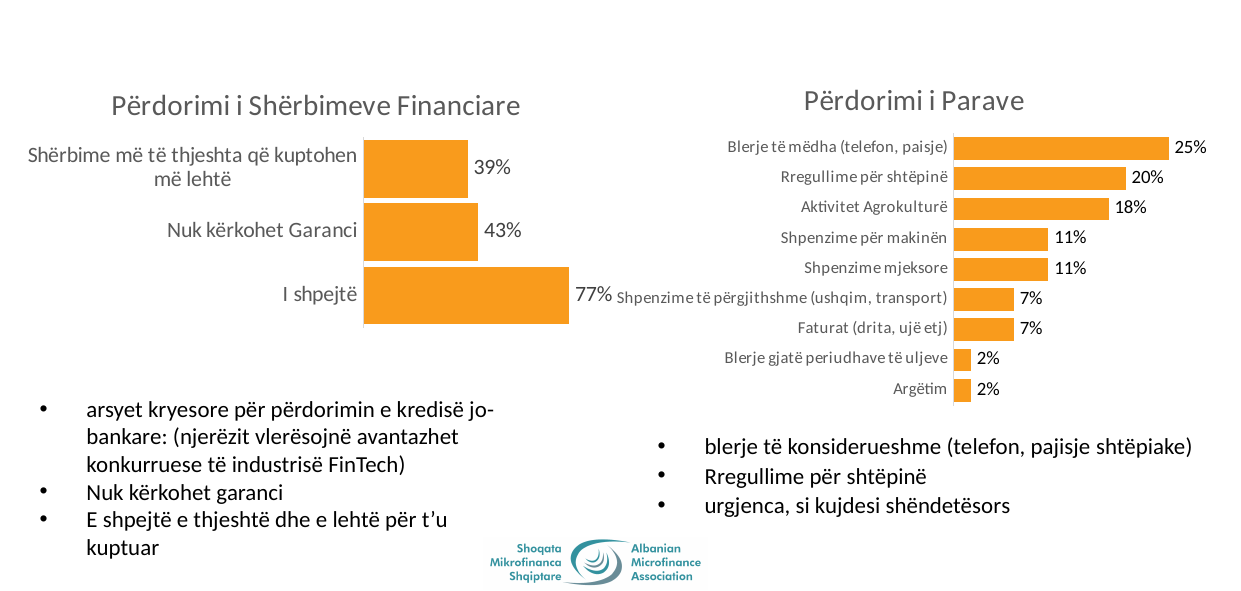
In the chart titled "Përdorimi i Parave", what is the value for "Aktivitet Agrokulturë"? 18% In the chart titled "Përdorimi i Parave", which is larger: "Shpenzime mjeksore" or "Faturat (drita, ujë etj)"? Shpenzime mjeksore In the chart titled "Përdorimi i Shërbimeve Financiare", what is the value for "Nuk kërkohet Garanci"? 43% In the chart titled "Përdorimi i Shërbimeve Financiare", which category has the lowest value? Shërbime më të thjeshta që kuptohen më lehtë In the chart titled "Përdorimi i Parave", what is the value for "Rregullime për shtëpinë"? 20% What type of chart is the chart titled "Përdorimi i Parave"? Bar chart In the chart titled "Përdorimi i Parave", how many categories are shown? 9 In the chart titled "Përdorimi i Shërbimeve Financiare", what is the value for "I shpejtë"? 77% In the chart titled "Përdorimi i Shërbimeve Financiare", how many categories are shown? 3 In the chart titled "Përdorimi i Parave", which category has the highest value? Blerje të mëdha (telefon, paisje) In the chart titled "Përdorimi i Shërbimeve Financiare", what is the difference between "I shpejtë" and "Nuk kërkohet Garanci"? 34% In the chart titled "Përdorimi i Parave", what is the difference between "Blerje të mëdha (telefon, paisje)" and "Shpenzime për makinën"? 14%